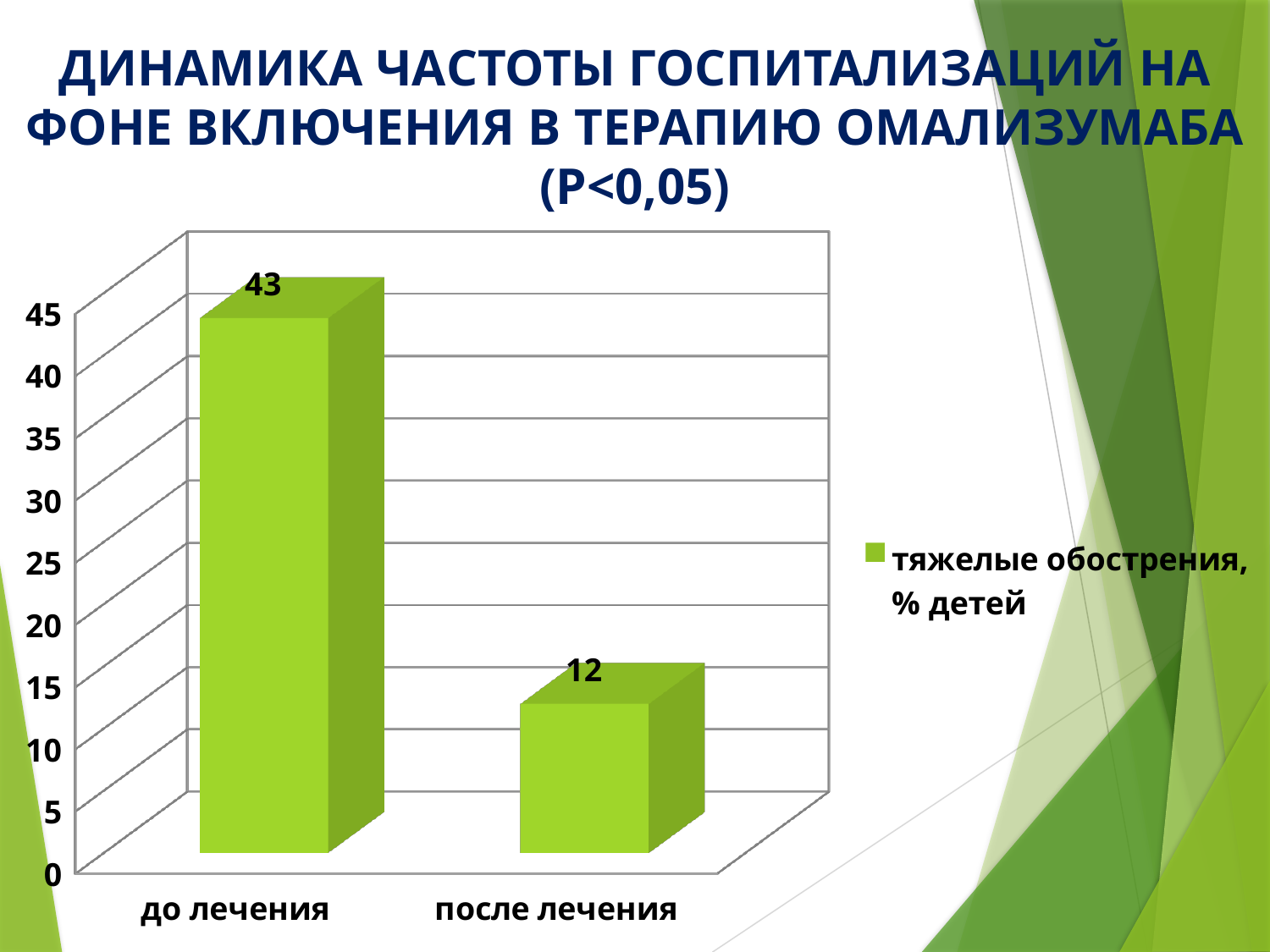
Which category has the highest value? до лечения Is the value for "после лечения" greater or less than 15? less How many series does the legend list? 1 What is the series name shown in the legend? тяжелые обострения, % детей What kind of chart is shown on the slide? bar chart How many categories are shown on the x axis? 2 Which category has the lowest value? после лечения What is the value for "до лечения"? 43 What is the value for "после лечения"? 12 Which is larger, the value for "до лечения" or for "после лечения"? до лечения What is the difference between the values for "до лечения" and "после лечения"? 31 Is the value for "до лечения" greater or less than 40? greater